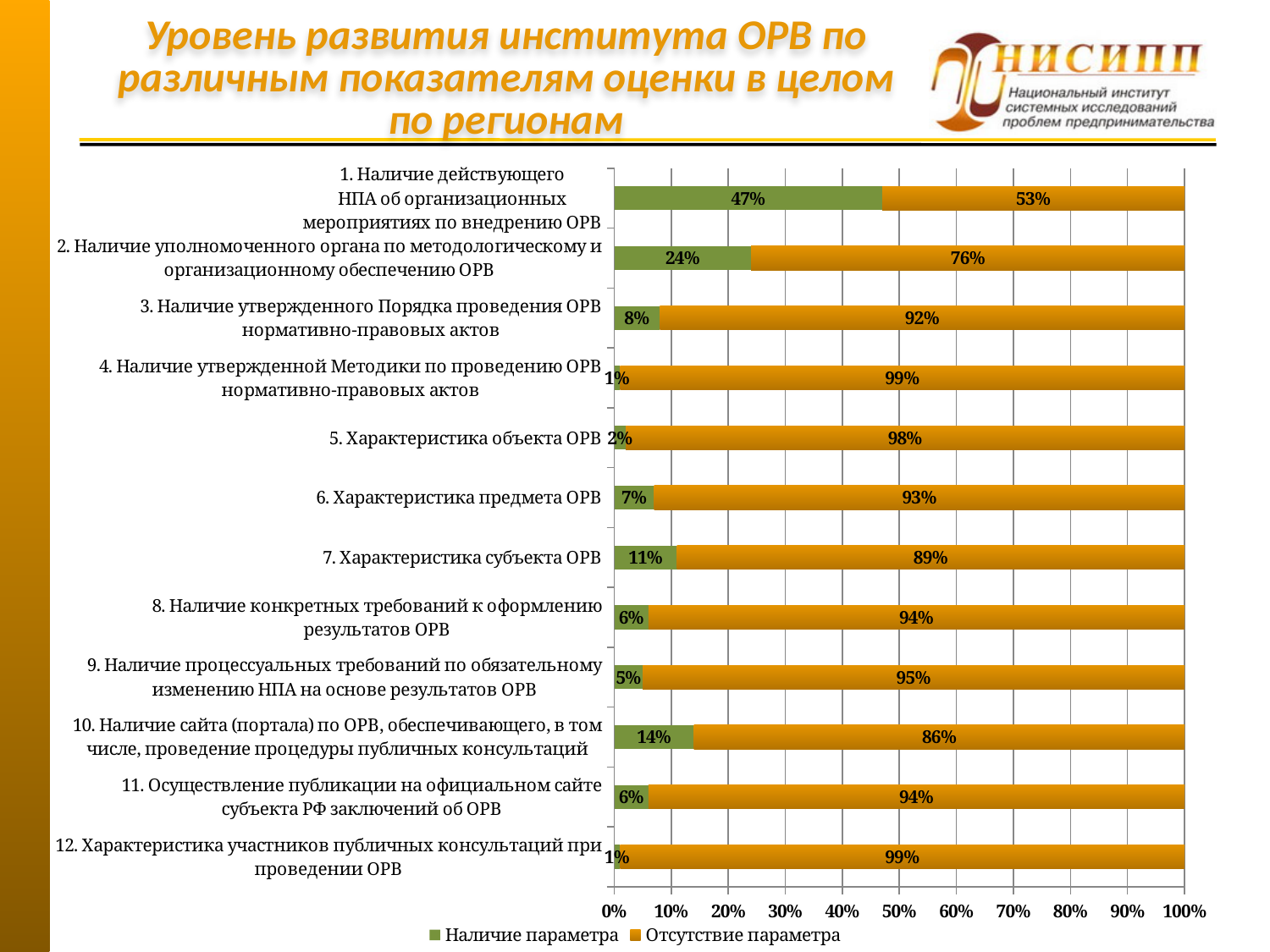
How many categories are plotted on the chart? 12 What kind of chart is shown on the slide? Stacked bar chart What is the value of "Наличие параметра" for category 1 (Наличие действующего НПА об организационных мероприятиях по внедрению ОРВ)? 47% What is the value of "Отсутствие параметра" for category 2 (Наличие уполномоченного органа по методологическому и организационному обеспечению ОРВ)? 76% Which colour represents "Отсутствие параметра" in the legend? Orange Which is larger for category 3 (Наличие утвержденного Порядка проведения ОРВ): "Наличие параметра" or "Отсутствие параметра"? Отсутствие параметра What is the difference between the "Отсутствие параметра" and "Наличие параметра" values for category 7 (Характеристика субъекта ОРВ)? 78% How many series does the legend list? 2 Which category has the highest value for "Наличие параметра"? 1. Наличие действующего НПА об организационных мероприятиях по внедрению ОРВ Which category has the highest value for "Отсутствие параметра"? 4. Наличие утвержденной Методики по проведению ОРВ нормативно-правовых актов and 12. Характеристика участников публичных консультаций при проведении ОРВ (both 99%) What is the value of "Наличие параметра" for category 10 (Наличие сайта (портала) по ОРВ)? 14% What is the total of the stacked bar for category 6 (Характеристика предмета ОРВ)? 100%